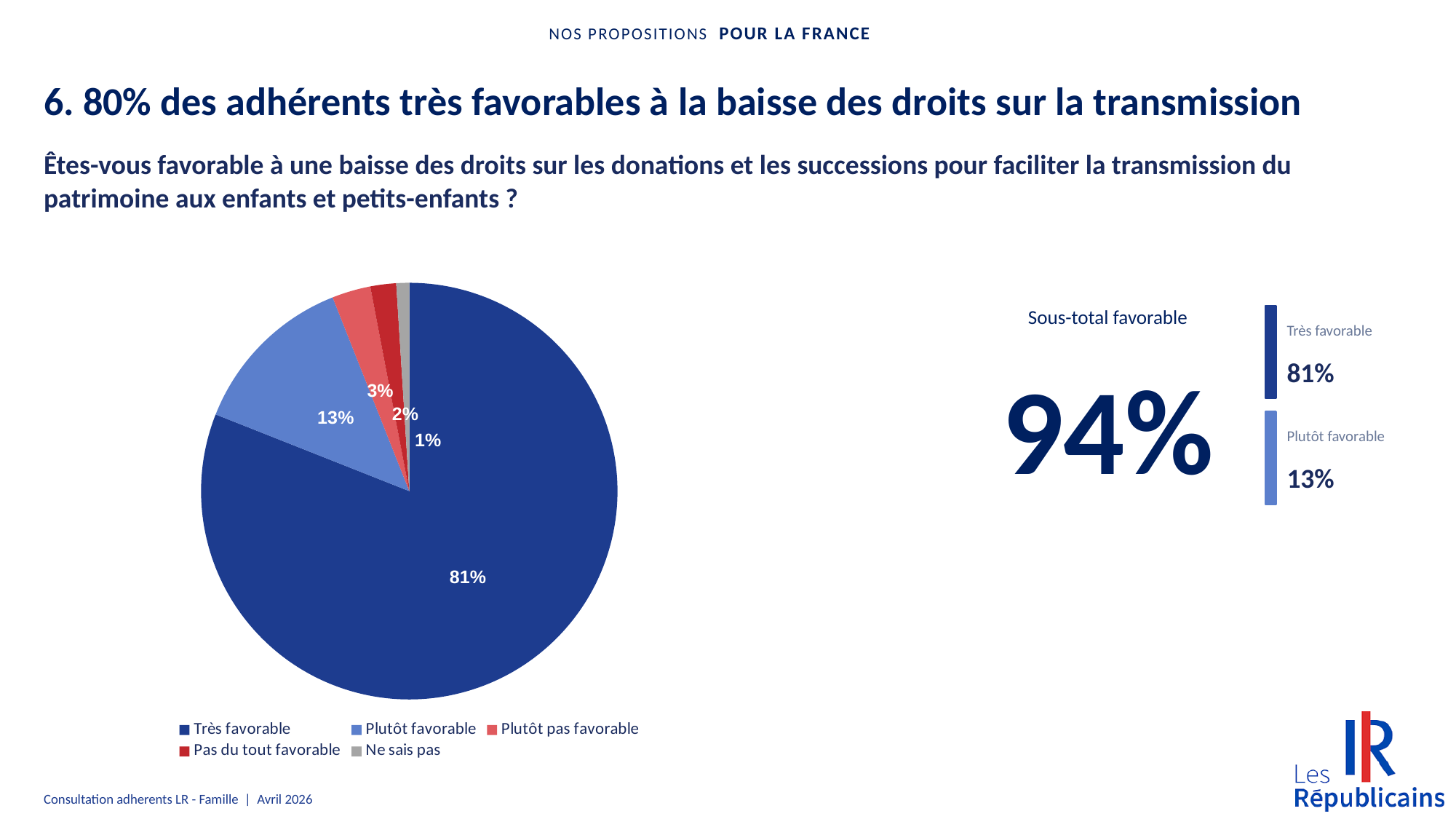
How many response categories does the legend list? 5 What kind of chart is shown on the slide? pie chart What percentage of respondents answered "Ne sais pas"? 1% What is the "Sous-total favorable" shown on the slide? 94% What percentage of respondents answered "Très favorable"? 81% Which response category has the smallest share of the pie? Ne sais pas What is the difference in percentage points between "Très favorable" and "Plutôt favorable"? 68 What percentage of respondents answered "Pas du tout favorable"? 2% Which response category has the largest share of the pie? Très favorable What percentage of respondents answered "Plutôt pas favorable"? 3% Which is larger, the share for "Plutôt pas favorable" or for "Pas du tout favorable"? Plutôt pas favorable What percentage of respondents answered "Plutôt favorable"? 13%